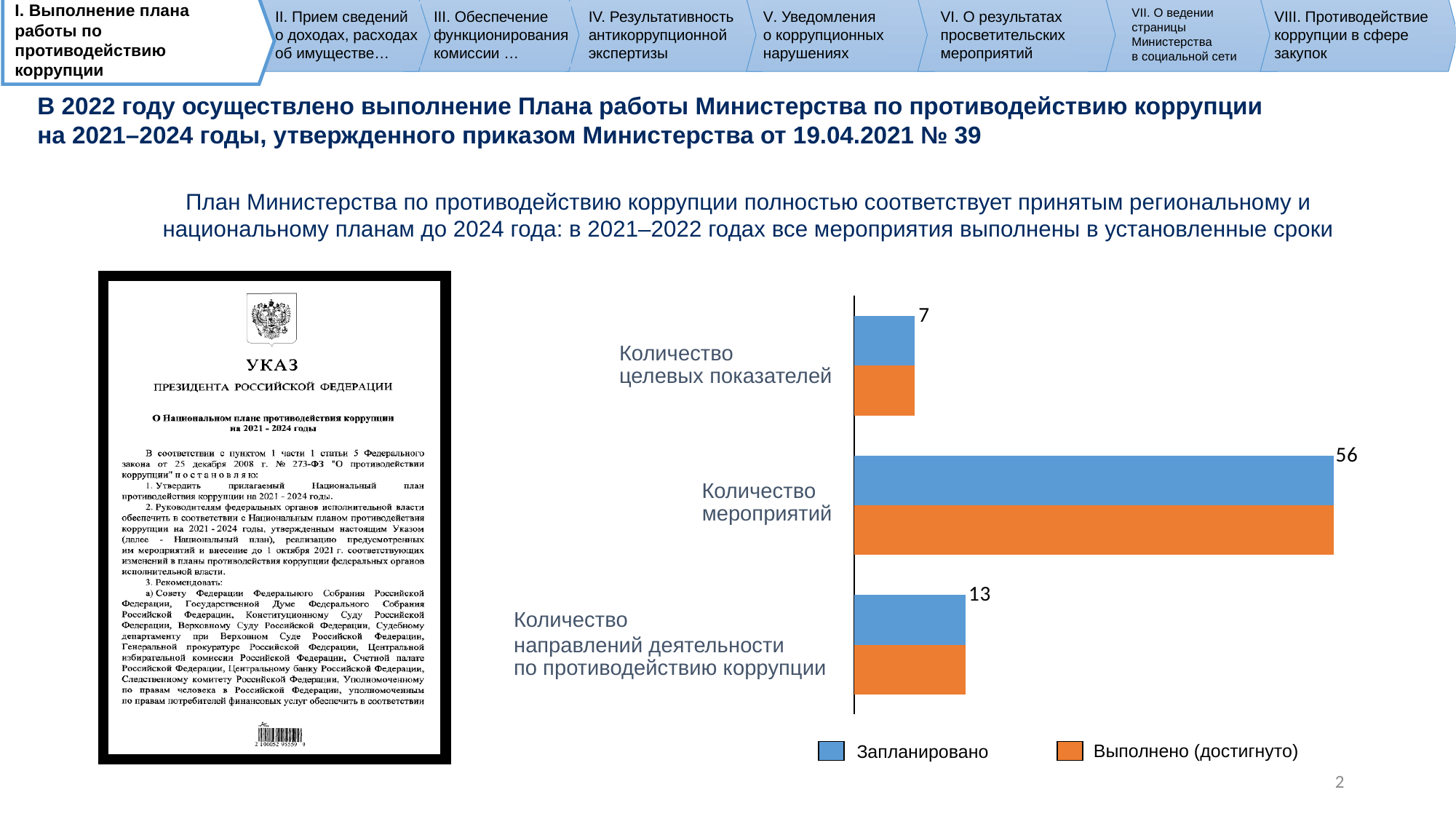
What is the value of the Запланировано bar for Количество целевых показателей? 7 What is the value of the Запланировано bar for Количество направлений деятельности по противодействию коррупции? 13 How many categories are shown in the chart? 3 What colour represents the Выполнено (достигнуто) series in the chart? Orange Which is larger: the Запланировано value for Количество мероприятий or for Количество целевых показателей? Количество мероприятий What kind of chart is shown on the slide? Bar chart Which category has the lowest Запланировано value? Количество целевых показателей What is the difference between the Запланировано values for Количество направлений деятельности по противодействию коррупции and Количество целевых показателей? 6 Which category has the highest Запланировано value? Количество мероприятий How many series does the legend list? 2 What is the difference between the Запланировано values for Количество мероприятий and Количество направлений деятельности по противодействию коррупции? 43 What is the value of the Запланировано bar for Количество мероприятий? 56